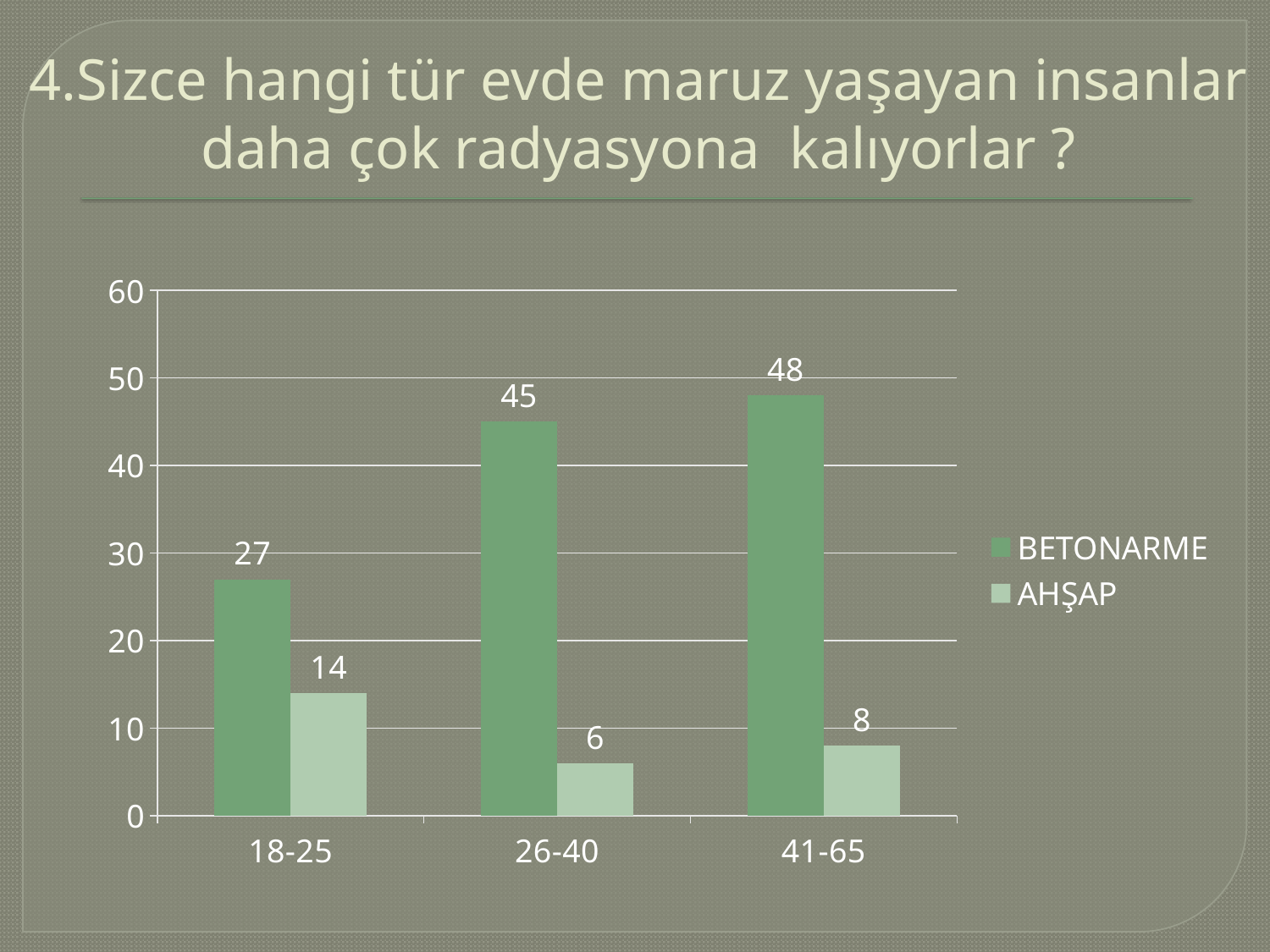
Is the BETONARME value for 26-40 greater or less than 40? greater How many series does the legend list? 2 Do the BETONARME values rise or fall from 18-25 to 41-65? rise Which is larger for the 26-40 age group, BETONARME or AHŞAP? BETONARME What is the difference between the BETONARME and AHŞAP values for the 18-25 age group? 13 What is the AHŞAP value for the 26-40 age group? 6 How many age groups are shown on the x axis? 3 Which age group has the highest BETONARME value? 41-65 What kind of chart is shown on the slide? bar chart What is the BETONARME value for the 41-65 age group? 48 What is the BETONARME value for the 18-25 age group? 27 Which age group has the lowest AHŞAP value? 26-40